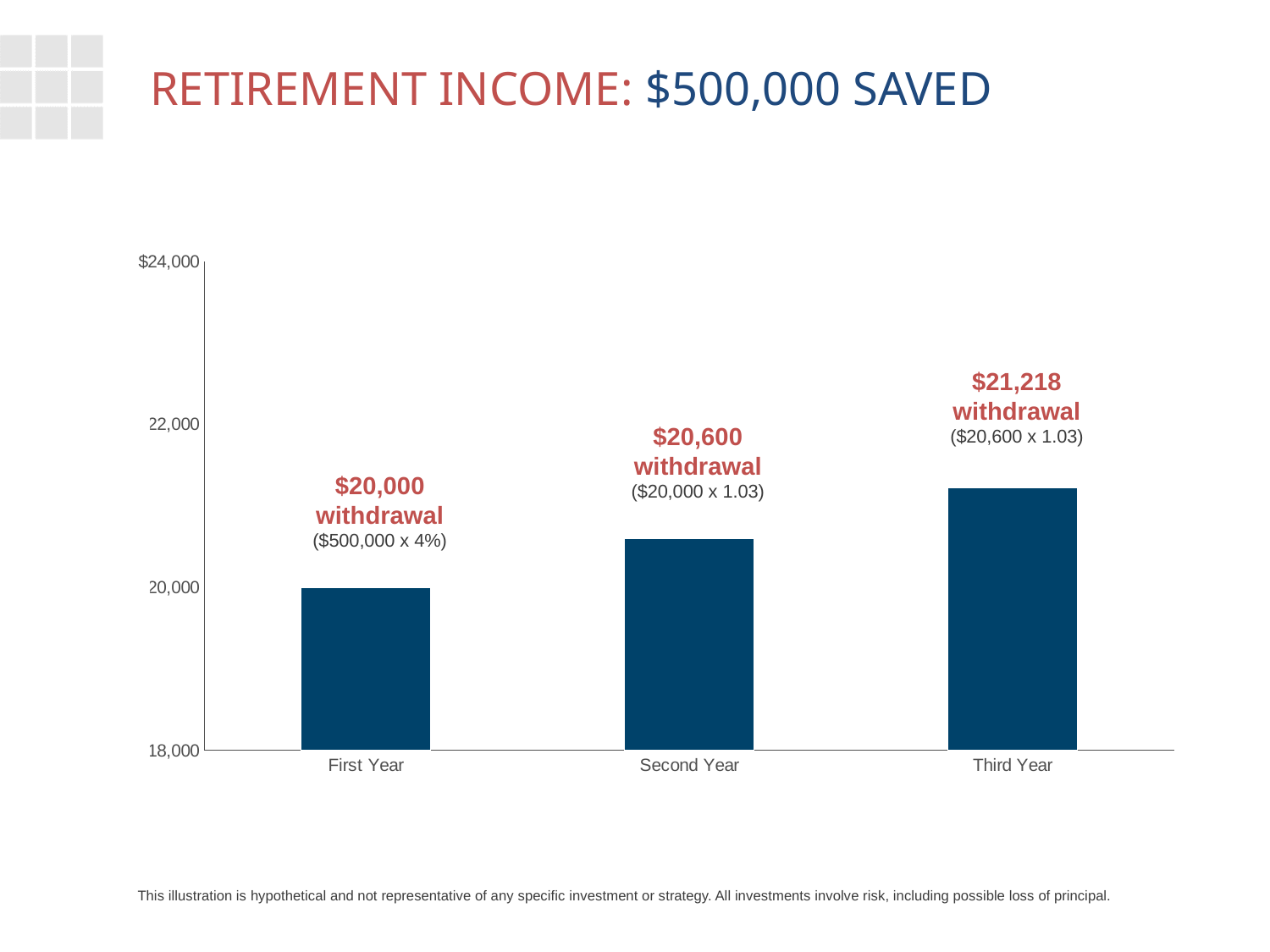
What is the withdrawal amount for the Third Year? $21,218 What is the withdrawal amount for the Second Year? $20,600 What is the difference between the Third Year and First Year withdrawals? $1,218 Do the withdrawal amounts rise or fall from First Year to Third Year? rise What is the withdrawal amount for the First Year? $20,000 How many years are shown on the chart? 3 Is the Third Year withdrawal greater or less than 22,000? less What kind of chart is shown on the slide? bar chart What is the difference between the Second Year and First Year withdrawals? $600 Which is larger, the Second Year withdrawal or the Third Year withdrawal? Third Year Which year has the lowest withdrawal? First Year Which year has the highest withdrawal? Third Year